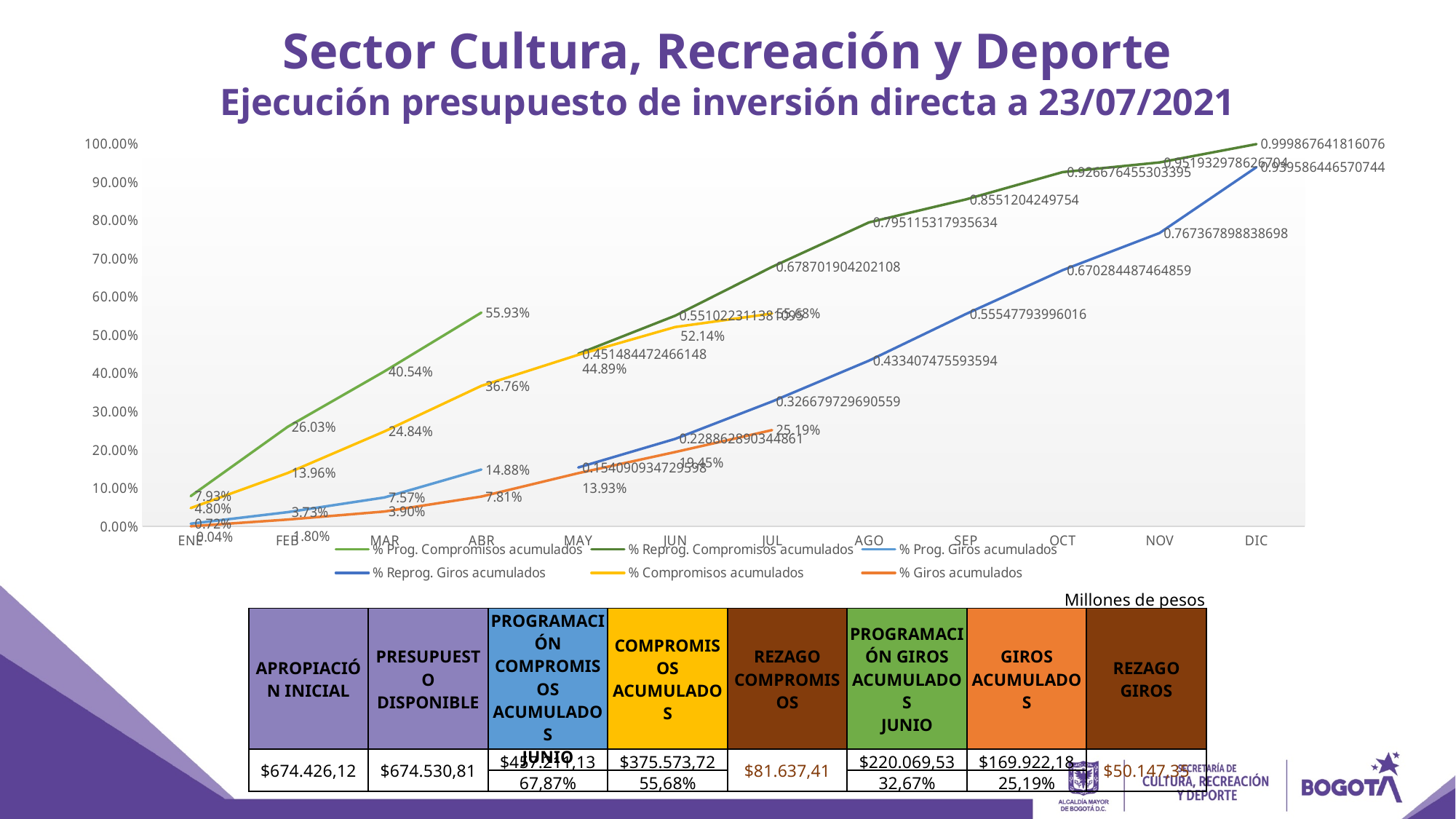
Does % Giros acumulados rise or fall from ENE to JUL? rise What is the value of % Prog. Compromisos acumulados in ABR? 55.93% How many series does the chart legend list? 6 What kind of chart is shown on the slide? line chart What is the value of % Prog. Giros acumulados in FEB? 3.73% What is the value of % Compromisos acumulados in MAR? 24.84% In ABR, which is larger: % Prog. Compromisos acumulados or % Compromisos acumulados? % Prog. Compromisos acumulados Is the value for % Reprog. Giros acumulados in OCT greater or less than 60.00%? greater How many months are shown along the x axis of the chart? 12 By how many percentage points does % Compromisos acumulados increase from MAR to ABR? 11.92 What is the data label for % Reprog. Compromisos acumulados in DIC? 0.999867641816076 What is the value of % Giros acumulados in JUL? 25.19%